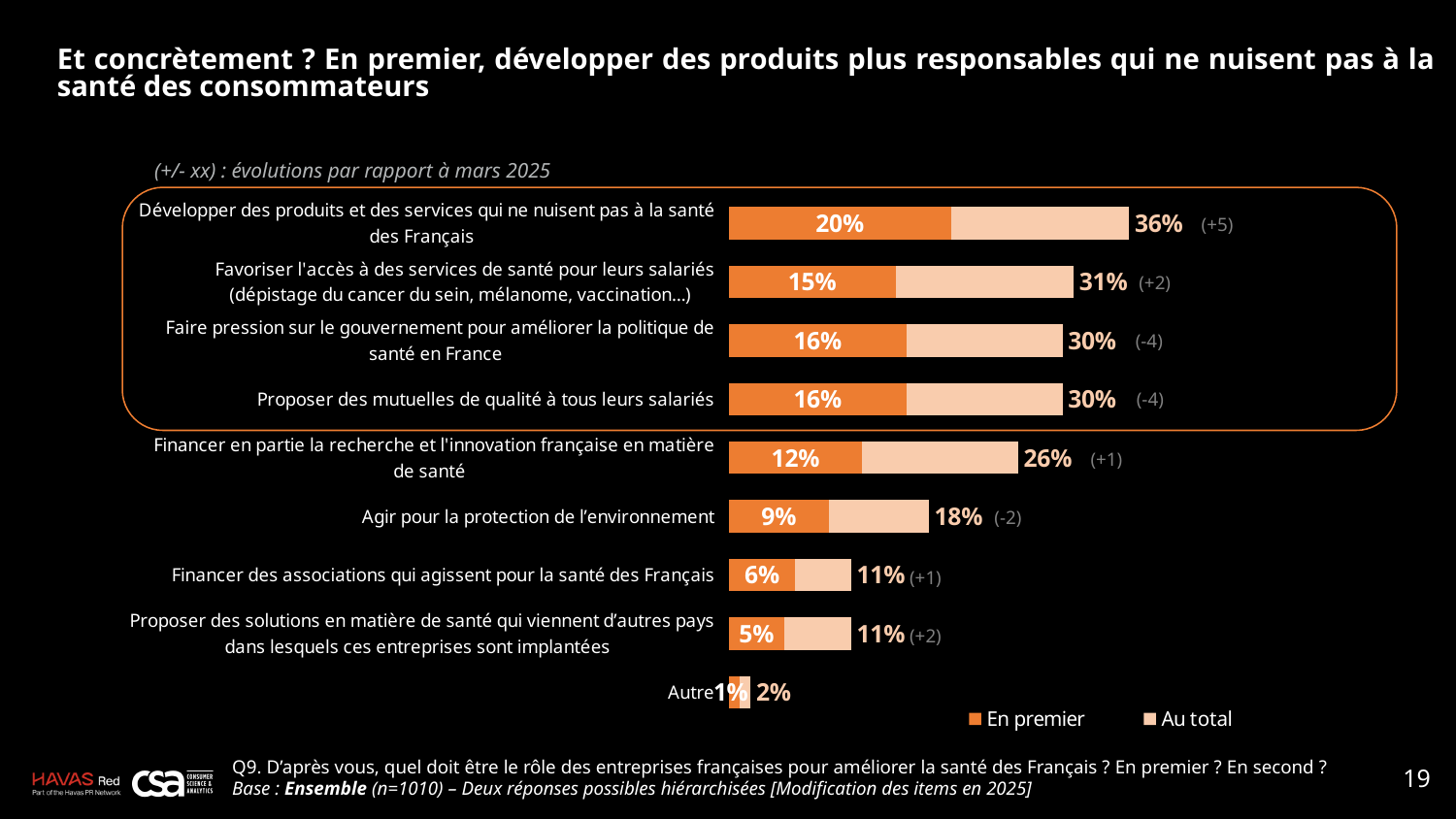
What evolution compared to March 2025 is shown for 'Développer des produits et des services qui ne nuisent pas à la santé des Français'? +5 How many categories are shown in the chart? 9 Which category has the lowest 'En premier' value? Autre Which category has the highest 'Au total' value? Développer des produits et des services qui ne nuisent pas à la santé des Français What are the two legend entries of the chart? En premier and Au total What is the 'Au total' value for 'Agir pour la protection de l'environnement'? 18% What kind of chart is shown on the slide? Bar chart Which has the larger 'En premier' value: 'Favoriser l'accès à des services de santé pour leurs salariés' or 'Faire pression sur le gouvernement pour améliorer la politique de santé en France'? Faire pression sur le gouvernement pour améliorer la politique de santé en France How many series does the legend list? 2 What is the 'En premier' value for 'Développer des produits et des services qui ne nuisent pas à la santé des Français'? 20% What is the 'En premier' value for 'Financer en partie la recherche et l'innovation française en matière de santé'? 12% What is the difference in 'Au total' values between 'Développer des produits et des services qui ne nuisent pas à la santé des Français' and 'Favoriser l'accès à des services de santé pour leurs salariés'? 5 percentage points